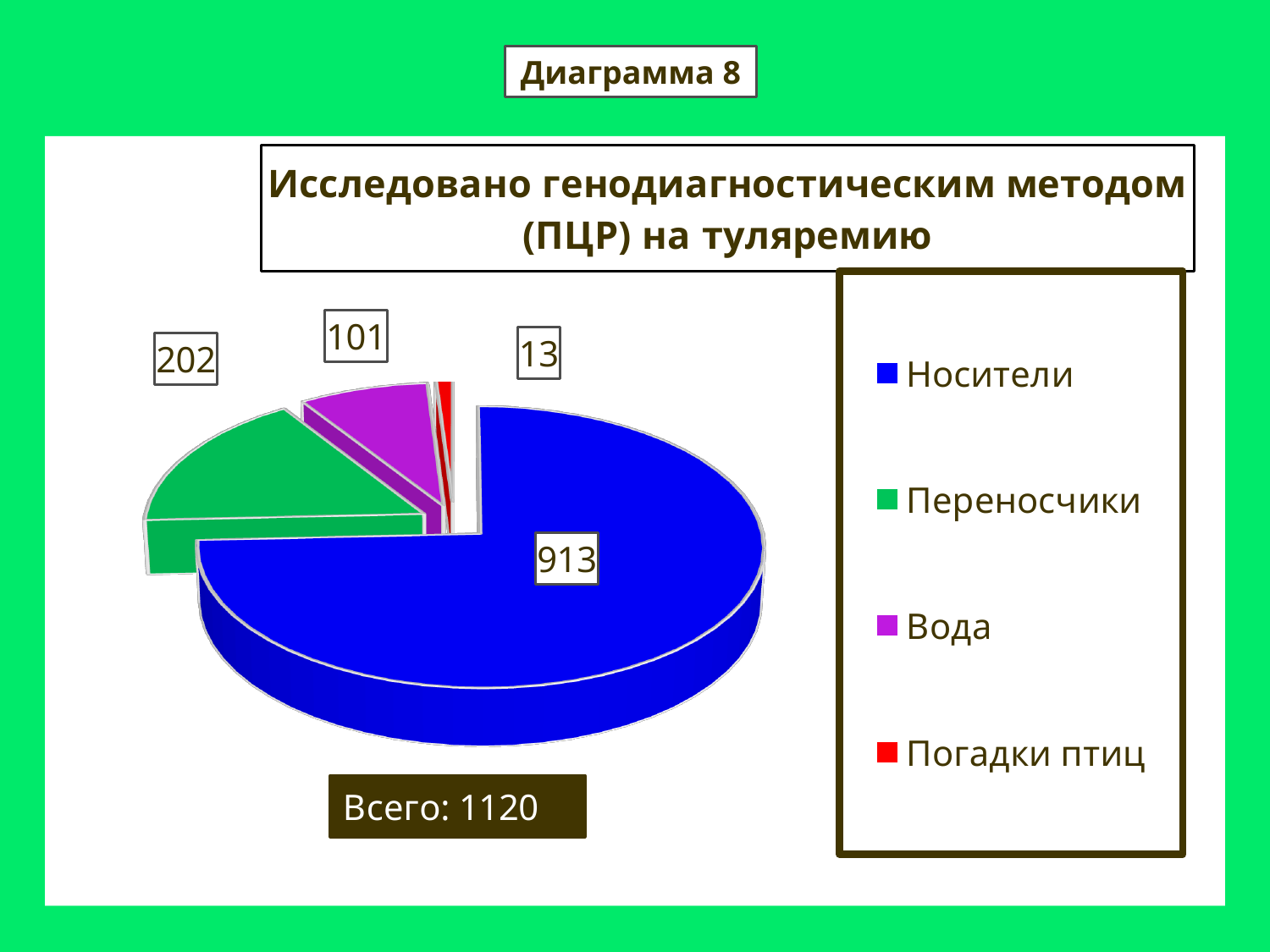
What is the difference between the values for Вода and Погадки птиц? 88 What is the value for Носители? 913 What is the difference between the values for Носители and Переносчики? 711 What is the value for Погадки птиц? 13 What total is printed below the chart? Всего: 1120 What is the value for Переносчики? 202 What kind of chart is shown on the slide? Pie chart Which category has the smallest slice? Погадки птиц How many categories does the pie chart show? 4 What is the value for Вода? 101 Which category has the largest slice? Носители Which is larger, the value for Переносчики or the value for Вода? Переносчики